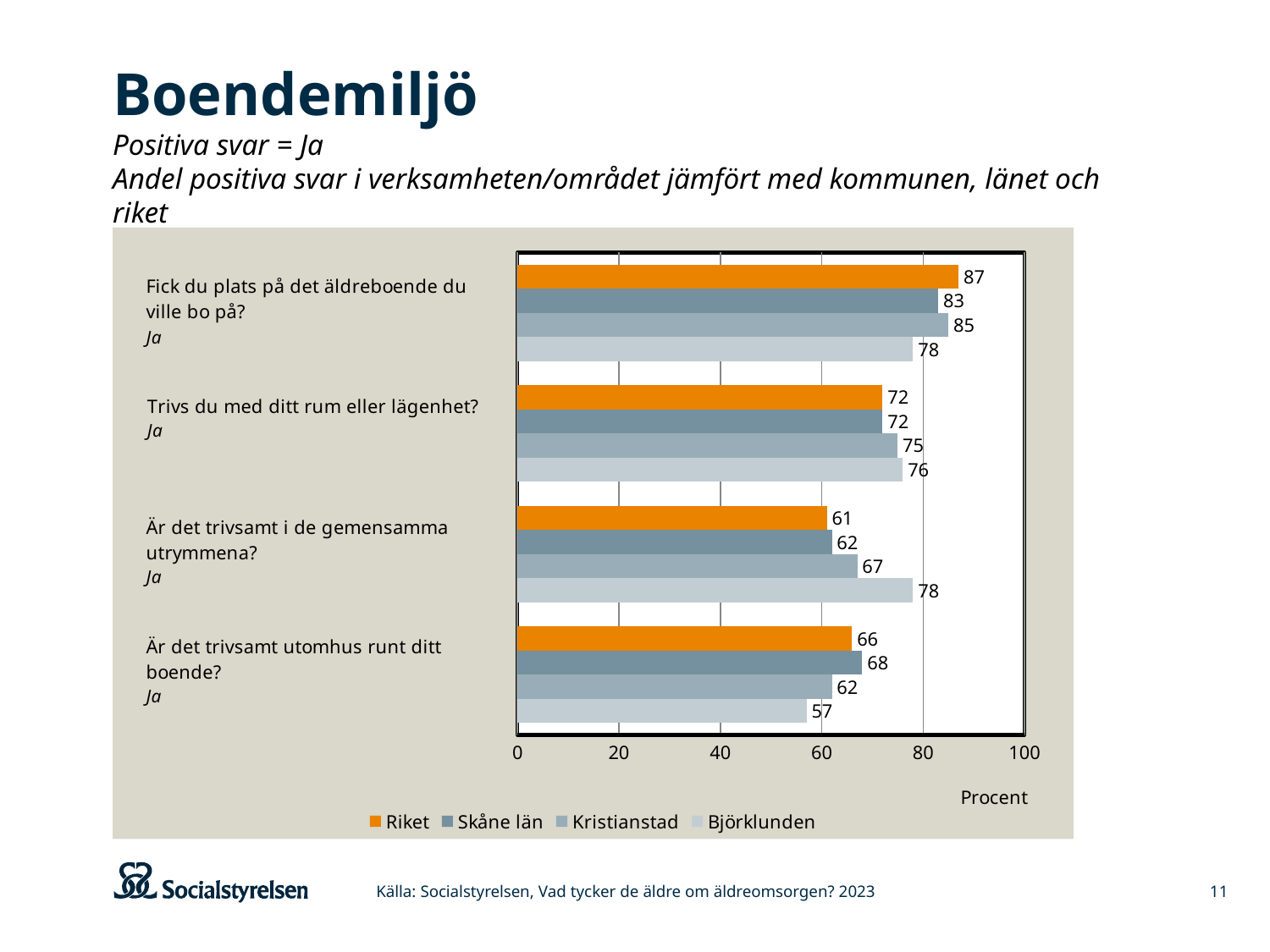
What kind of chart is shown on the slide? Bar chart What is the value for Skåne län for "Är det trivsamt utomhus runt ditt boende?"? 68 What is the value for Riket for "Fick du plats på det äldreboende du ville bo på?"? 87 What is the difference between the Björklunden and Riket values for "Är det trivsamt i de gemensamma utrymmena?"? 17 How many questions (categories) are shown on the chart? 4 How many series does the legend list? 4 What is the value for Björklunden for "Är det trivsamt i de gemensamma utrymmena?"? 78 What is the label on the horizontal axis of the chart? Procent Which is larger for "Är det trivsamt utomhus runt ditt boende?": the value for Riket or the value for Kristianstad? Riket Which series has the highest value for "Fick du plats på det äldreboende du ville bo på?"? Riket Which series has the lowest value for "Är det trivsamt utomhus runt ditt boende?"? Björklunden What is the value for Kristianstad for "Trivs du med ditt rum eller lägenhet?"? 75